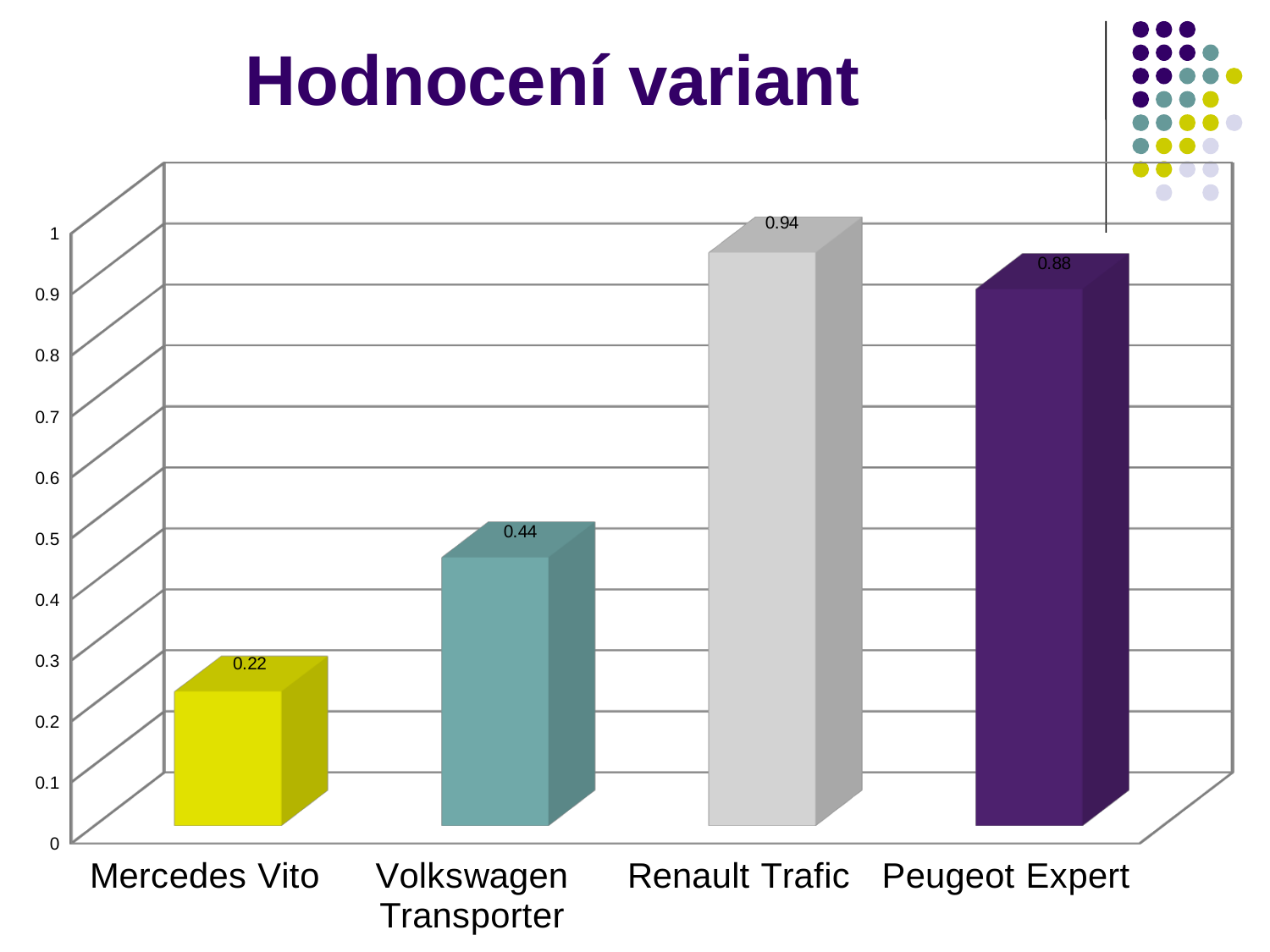
Is the value for Volkswagen Transporter greater or less than 0.5? less What is the value for Volkswagen Transporter? 0.44 What is the value for Renault Trafic? 0.94 Which category has the highest value? Renault Trafic What is the value for Mercedes Vito? 0.22 What is the value for Peugeot Expert? 0.88 Which is larger, the value for Volkswagen Transporter or the value for Peugeot Expert? Peugeot Expert Which category has the lowest value? Mercedes Vito What is the difference between the values for Renault Trafic and Peugeot Expert? 0.06 What is the difference between the values for Volkswagen Transporter and Mercedes Vito? 0.22 How many categories are shown on the chart? 4 What kind of chart is shown on the slide? bar chart